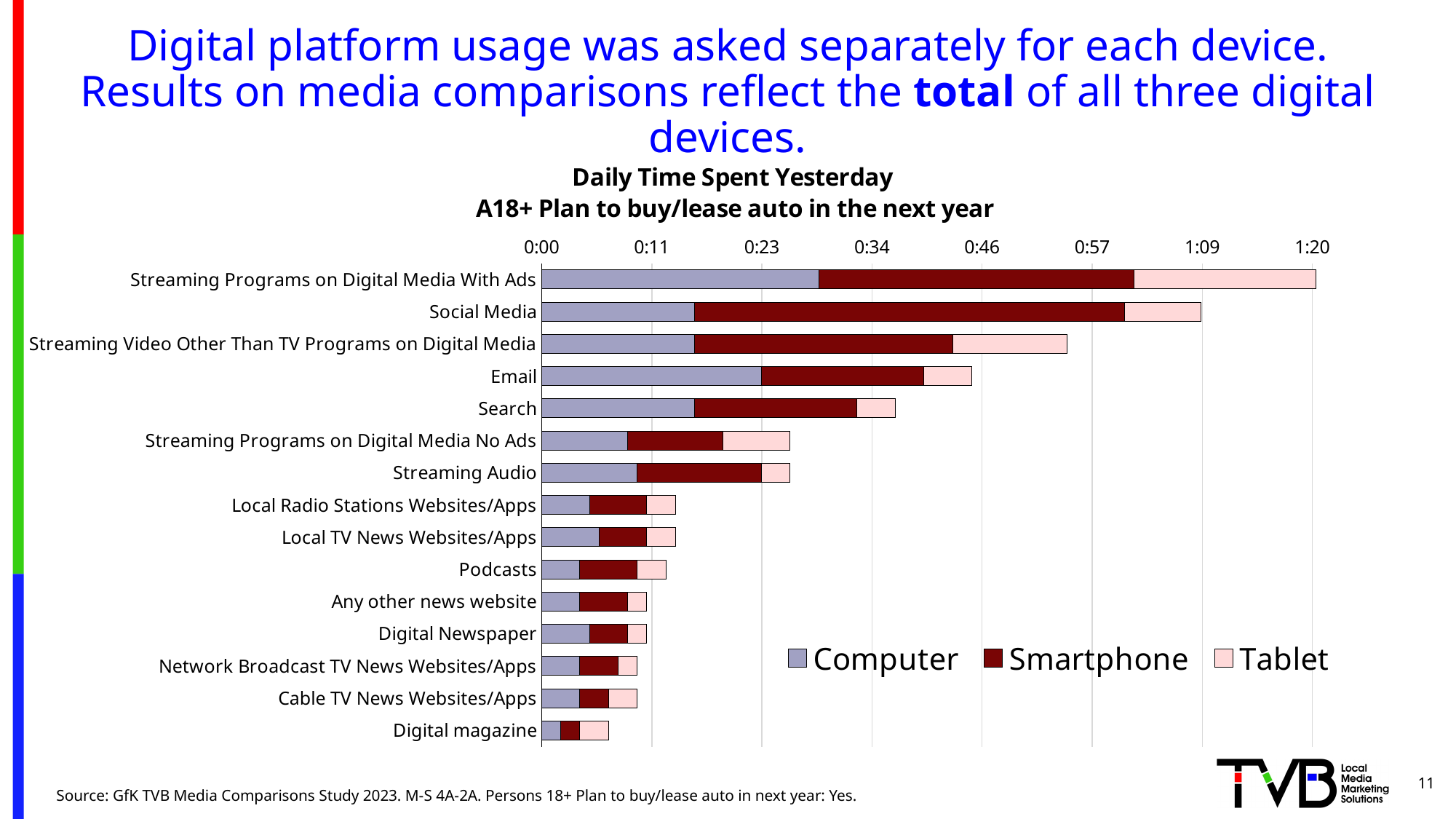
How many categories are plotted on the chart? 15 What kind of chart is shown on the slide? Stacked bar chart Is the total bar for Streaming Audio greater or less than 0:23? greater Is the total bar for Search greater or less than 0:34? greater Which category has the longest total bar? Streaming Programs on Digital Media With Ads Which series is shown in dark red in the legend? Smartphone Which has the longer total bar, Social Media or Email? Social Media Which category has the shortest total bar? Digital magazine Is the total bar for Digital magazine greater or less than 0:11? less How many series does the legend list? 3 Which has the longer total bar, Streaming Audio or Podcasts? Streaming Audio